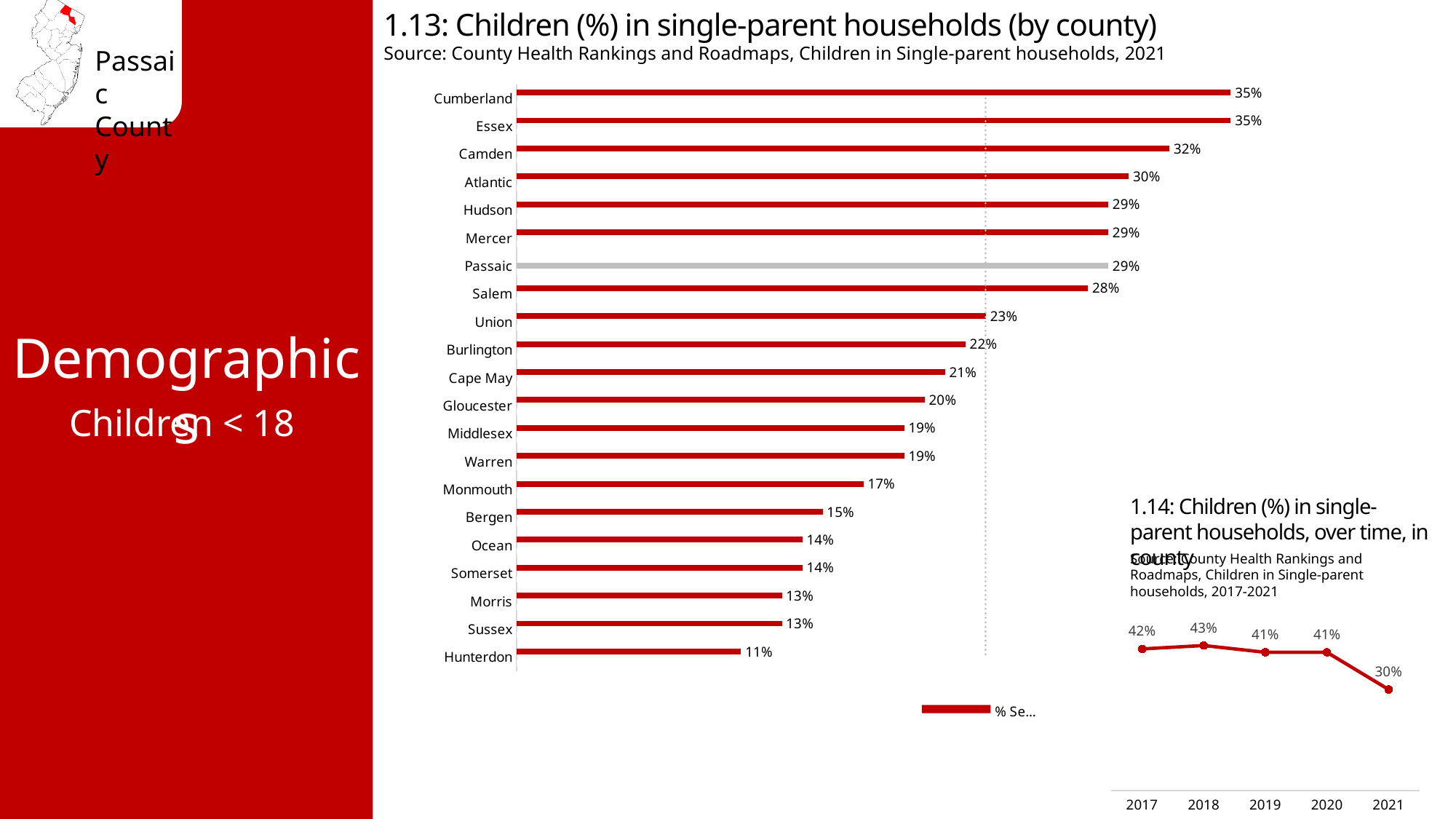
In chart 1.13 (Children (%) in single-parent households by county), which county has the lowest value? Hunterdon In chart 1.13 (Children (%) in single-parent households by county), what is the value for Passaic? 29% In chart 1.14 (Children (%) in single-parent households over time, in county), what is the value for 2021? 30% In chart 1.14 (Children (%) in single-parent households over time, in county), what is the difference between the 2017 and 2021 values? 12% What kind of chart is chart 1.14 (Children (%) in single-parent households over time, in county)? Line chart In chart 1.13 (Children (%) in single-parent households by county), what is the difference between Cumberland and Hunterdon? 24% In chart 1.13 (Children (%) in single-parent households by county), which is larger, the value for Camden or the value for Union? Camden In chart 1.13 (Children (%) in single-parent households by county), what is the value for Hunterdon? 11% In chart 1.13 (Children (%) in single-parent households by county), what is the value for Monmouth? 17% In chart 1.14 (Children (%) in single-parent households over time, in county), which year has the highest value? 2018 In chart 1.13 (Children (%) in single-parent households by county), how many counties are shown? 21 What kind of chart is chart 1.13 (Children (%) in single-parent households by county)? Bar chart